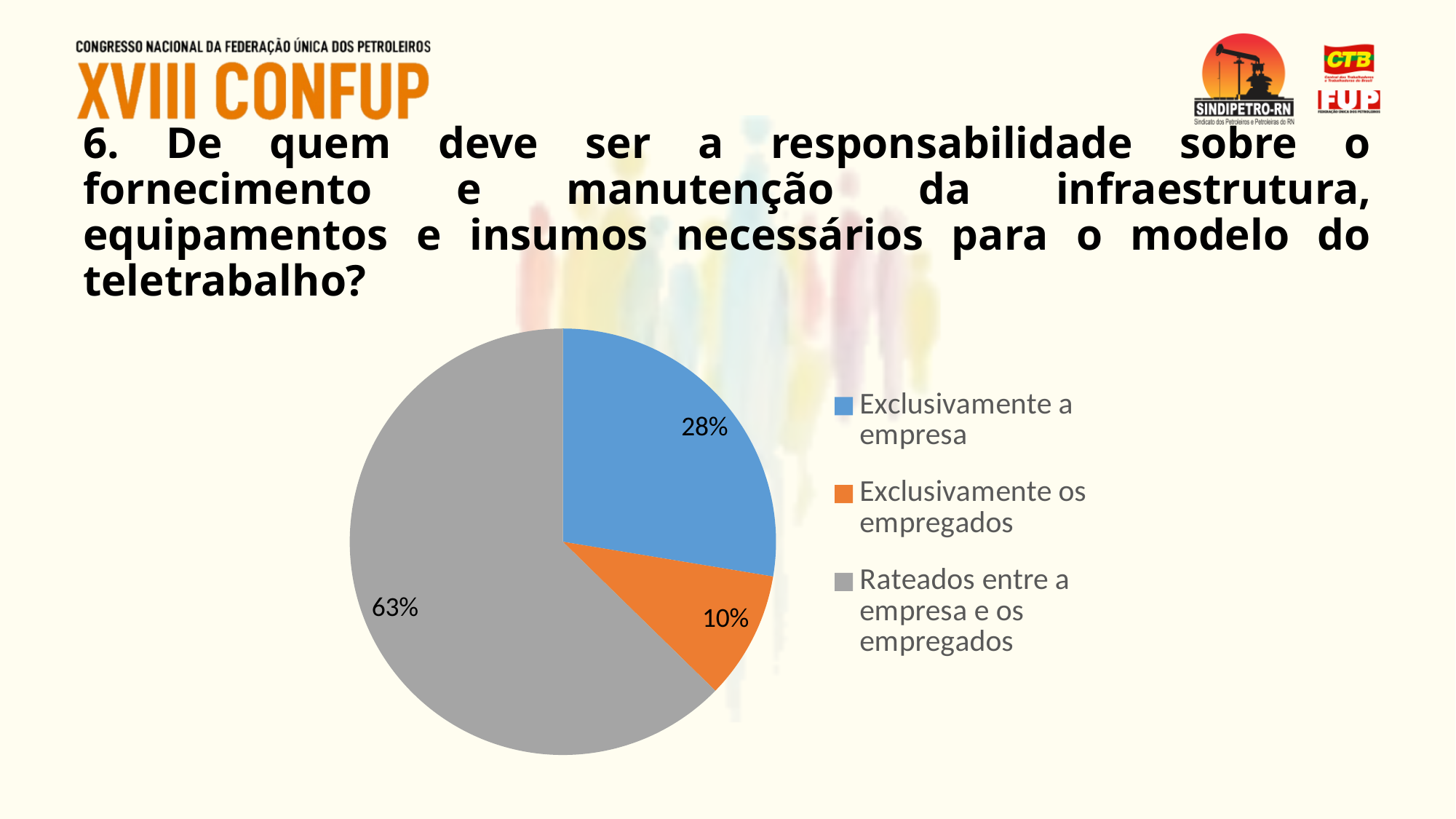
Which category has the smallest slice of the pie? Exclusivamente os empregados Which is larger: the slice for "Exclusivamente a empresa" or the slice for "Exclusivamente os empregados"? Exclusivamente a empresa What share of the pie does "Exclusivamente os empregados" have? 10% How many categories does the pie chart have? 3 What share of the pie does "Exclusivamente a empresa" have? 28% What is the difference in percentage points between "Rateados entre a empresa e os empregados" and "Exclusivamente a empresa"? 35 What share of the pie does "Rateados entre a empresa e os empregados" have? 63% What kind of chart is shown on the slide? pie chart What colour is the slice for "Rateados entre a empresa e os empregados"? grey What is the difference in percentage points between "Exclusivamente a empresa" and "Exclusivamente os empregados"? 18 What colour is the slice for "Exclusivamente os empregados"? orange Which category has the largest slice of the pie? Rateados entre a empresa e os empregados